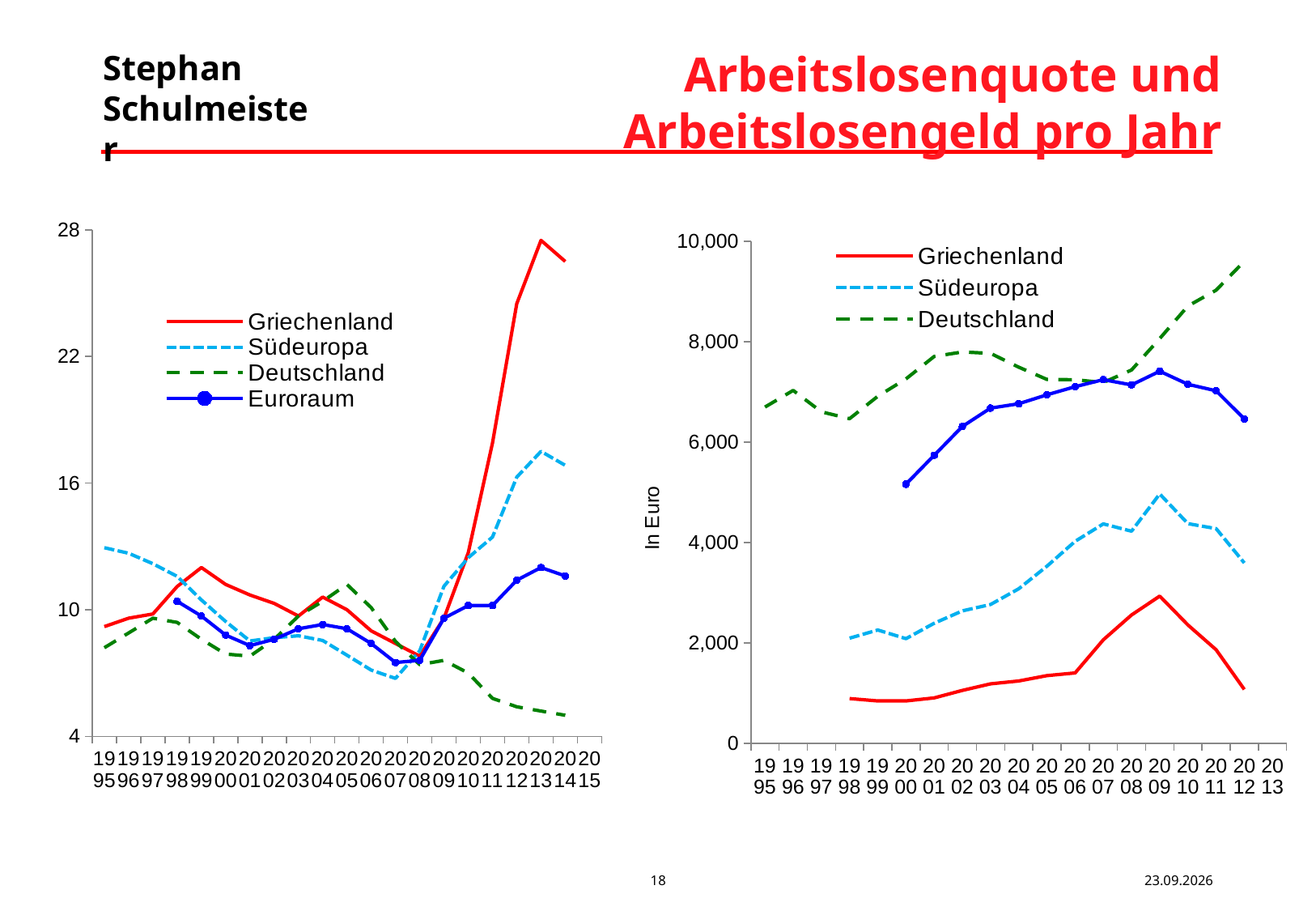
What kind of chart is the left chart on the slide? line chart How many series does the legend of the left chart list? 4 In the left chart, is the value for Griechenland in 2013 greater or less than 22? greater What is the y-axis label of the right chart? In Euro In the right chart, does the Griechenland line rise or fall between 2009 and 2012? fall In the right chart, is the value for Griechenland in 2012 greater or less than 2,000? less In the left chart, is the value for Deutschland in 2014 greater or less than 10? less How many series does the legend of the right chart list? 3 In the left chart, which series has the highest value in 2013? Griechenland In the right chart, which series has the lowest value in 2012? Griechenland In the left chart, does the Griechenland line rise or fall between 2008 and 2013? rise